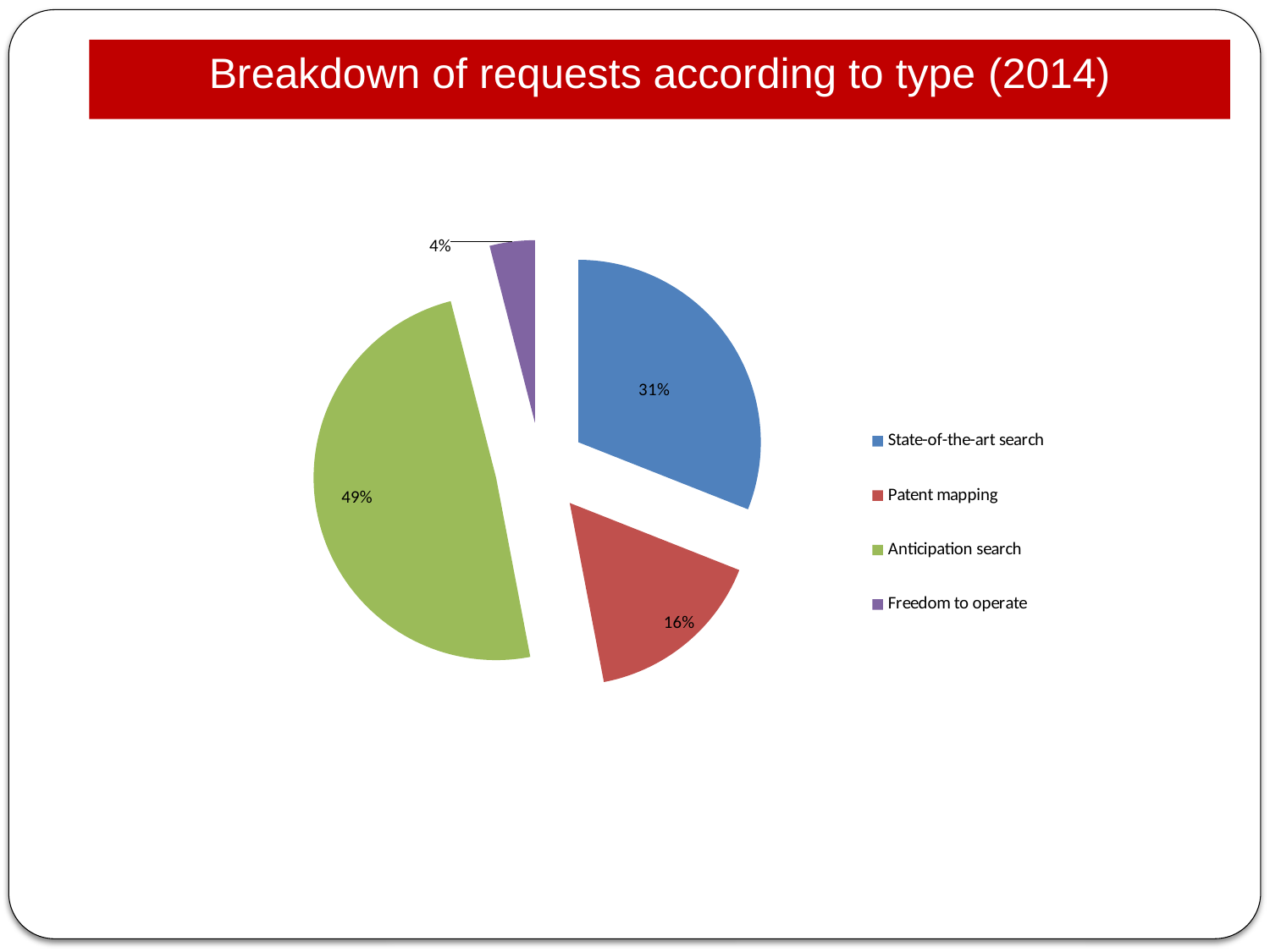
Which request type has the largest share? Anticipation search What share of requests is State-of-the-art search? 31% Which has a larger share, State-of-the-art search or Patent mapping? State-of-the-art search Which request type has the smallest share? Freedom to operate What colour is the Anticipation search slice? Green What is the difference in percentage points between Patent mapping and Freedom to operate? 12 What share of requests is Patent mapping? 16% What share of requests is Freedom to operate? 4% What is the difference in percentage points between Anticipation search and State-of-the-art search? 18 How many request types are shown in the pie chart? 4 What kind of chart is shown on the slide? Pie chart